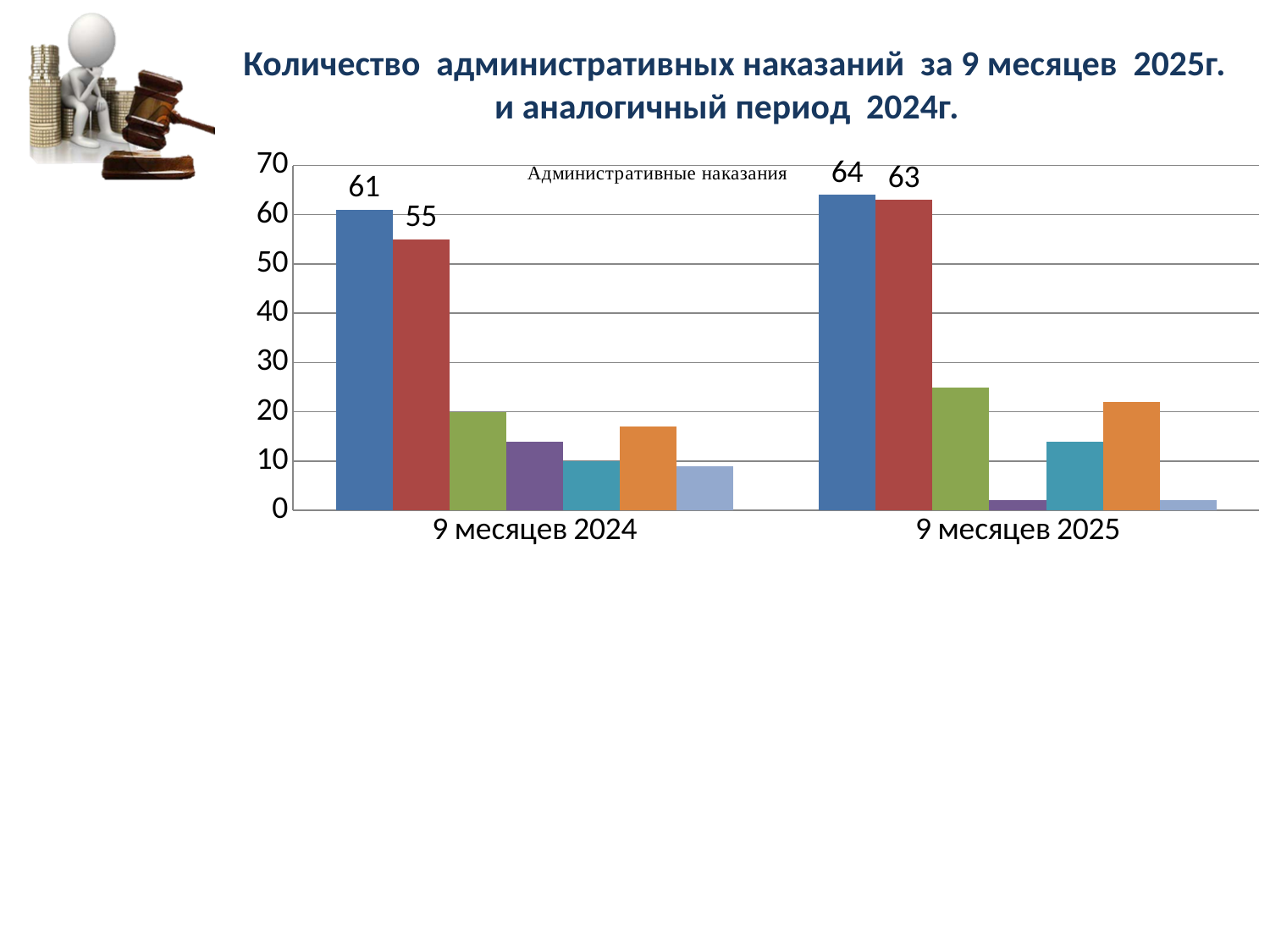
What kind of chart is shown on the slide? bar chart How many categories are shown on the x axis? 2 By how much does the dark blue bar for 9 месяцев 2025 exceed the dark blue bar for 9 месяцев 2024? 3 What is the value of the dark blue bar for 9 месяцев 2025? 64 Is the value of the green bar for 9 месяцев 2025 greater or less than 20? greater Which is larger for 9 месяцев 2024: the dark blue bar or the red bar? the dark blue bar What is the value of the red bar for 9 месяцев 2025? 63 Is the value of the purple bar for 9 месяцев 2025 greater or less than 10? less What is the difference between the red bars for 9 месяцев 2025 and 9 месяцев 2024? 8 What is the value of the red bar for 9 месяцев 2024? 55 What is the title printed inside the chart area? Административные наказания What is the value of the dark blue bar for 9 месяцев 2024? 61